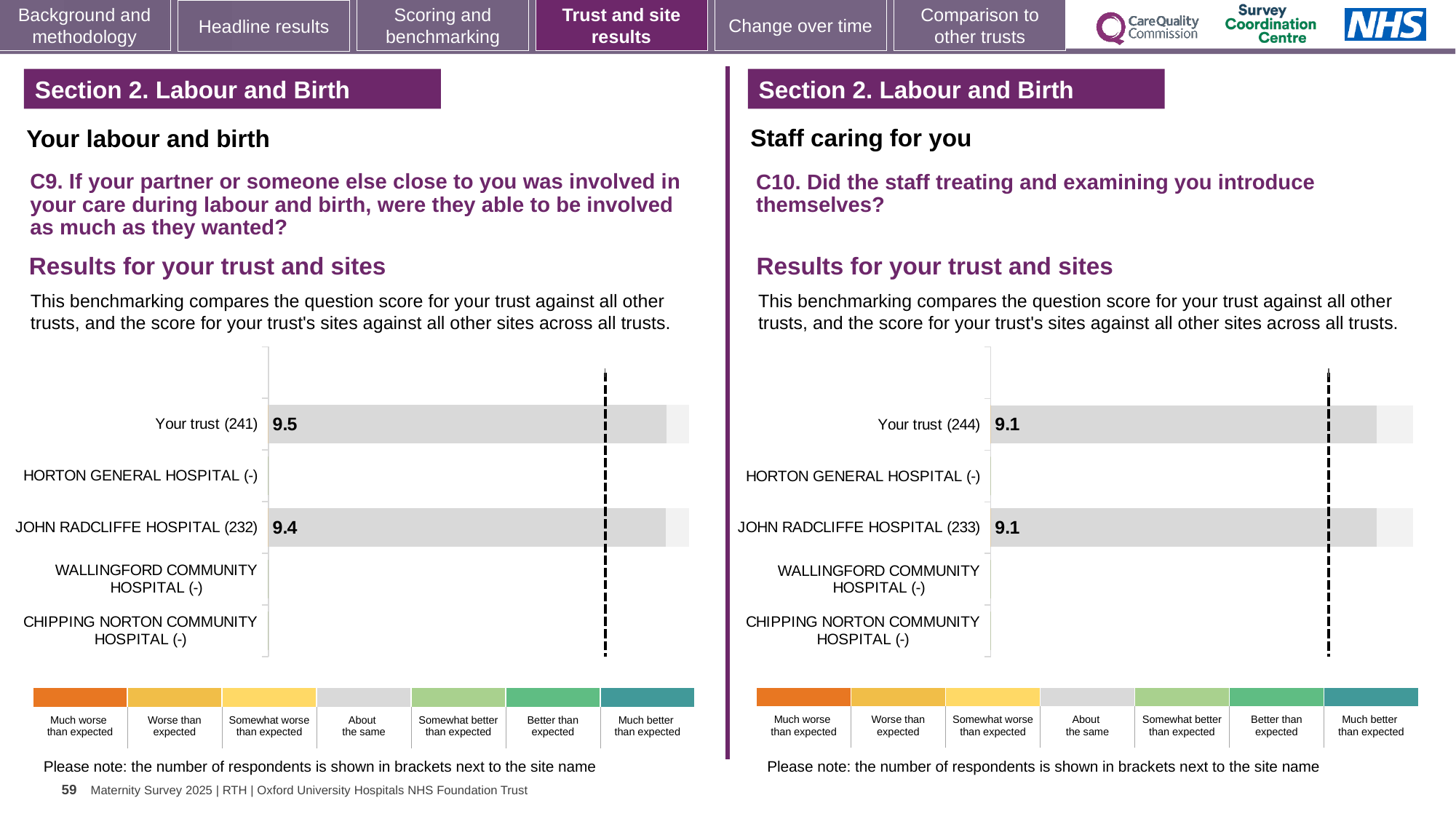
In the C9 chart on the left, what is the score for Your trust? 9.5 In the C10 chart on the right, what is the score for JOHN RADCLIFFE HOSPITAL? 9.1 In the C10 chart on the right, how many respondents are shown in brackets for JOHN RADCLIFFE HOSPITAL? 233 In the C9 chart on the left, what is the difference between the score for Your trust and the score for JOHN RADCLIFFE HOSPITAL? 0.1 In the C10 chart on the right, what is the score for Your trust? 9.1 In the C9 chart on the left, which has the higher score, Your trust or JOHN RADCLIFFE HOSPITAL? Your trust How many colour categories does the legend below the C10 chart on the right show? 7 In the C9 chart on the left, how many respondents are shown in brackets for Your trust? 241 How many site or trust categories are listed on the y axis of the C10 chart on the right? 5 In the C9 chart on the left, what is the score for JOHN RADCLIFFE HOSPITAL? 9.4 How many site or trust categories are listed on the y axis of the C9 chart on the left? 5 What kind of chart is used for the C9 results on the left? Bar chart